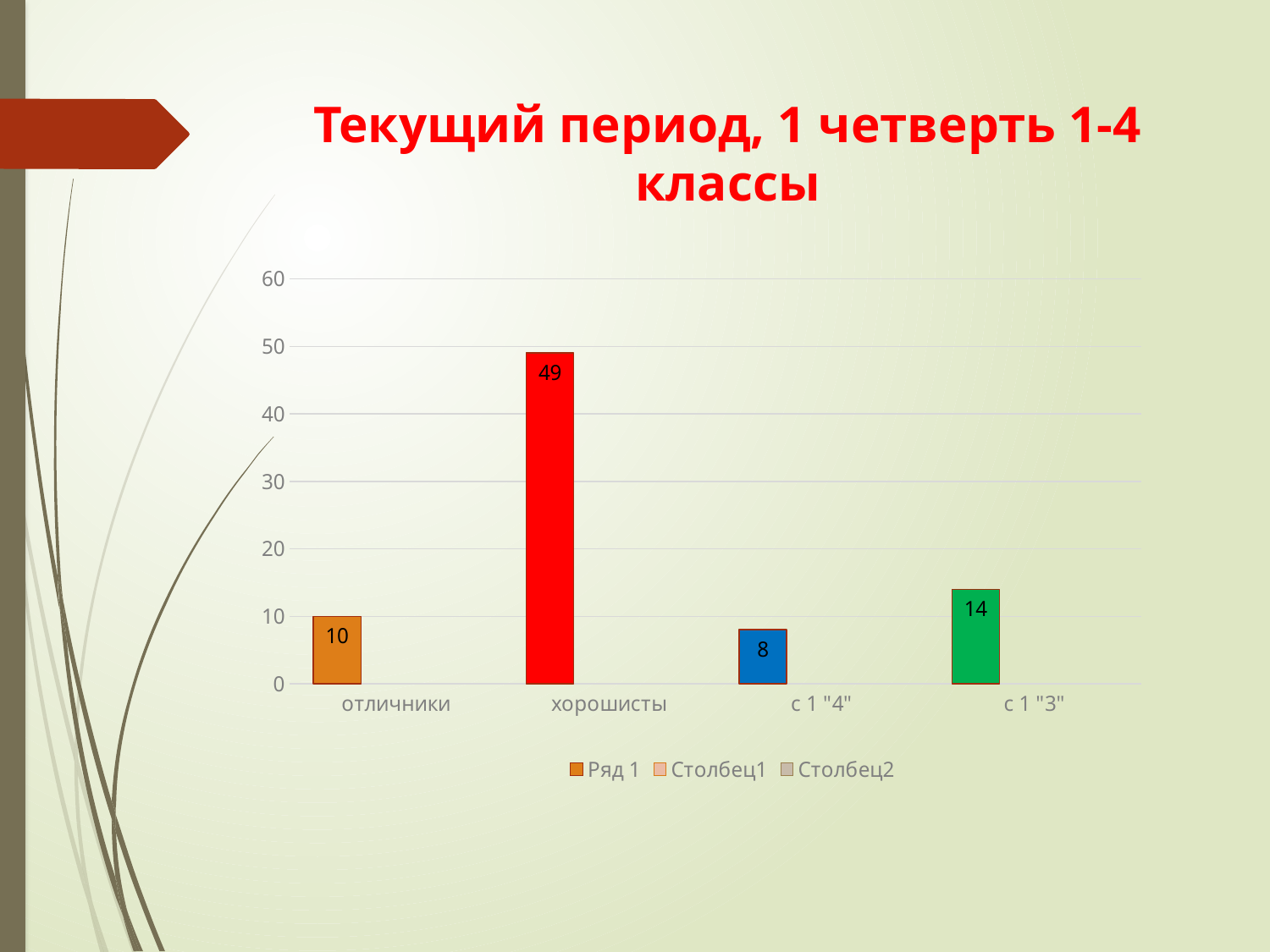
What is the difference between the values for хорошисты and с 1 "3"? 35 What is the value for с 1 "3"? 14 Is the value for хорошисты greater or less than 40? greater What kind of chart is shown on the slide? bar chart What is the value for отличники? 10 How many series does the legend list? 3 What is the value for с 1 "4"? 8 Which category has the lowest value? с 1 "4" How many categories are shown on the x axis? 4 What is the value for хорошисты? 49 Which is larger, the value for отличники or the value for с 1 "3"? с 1 "3" Which category has the highest value? хорошисты